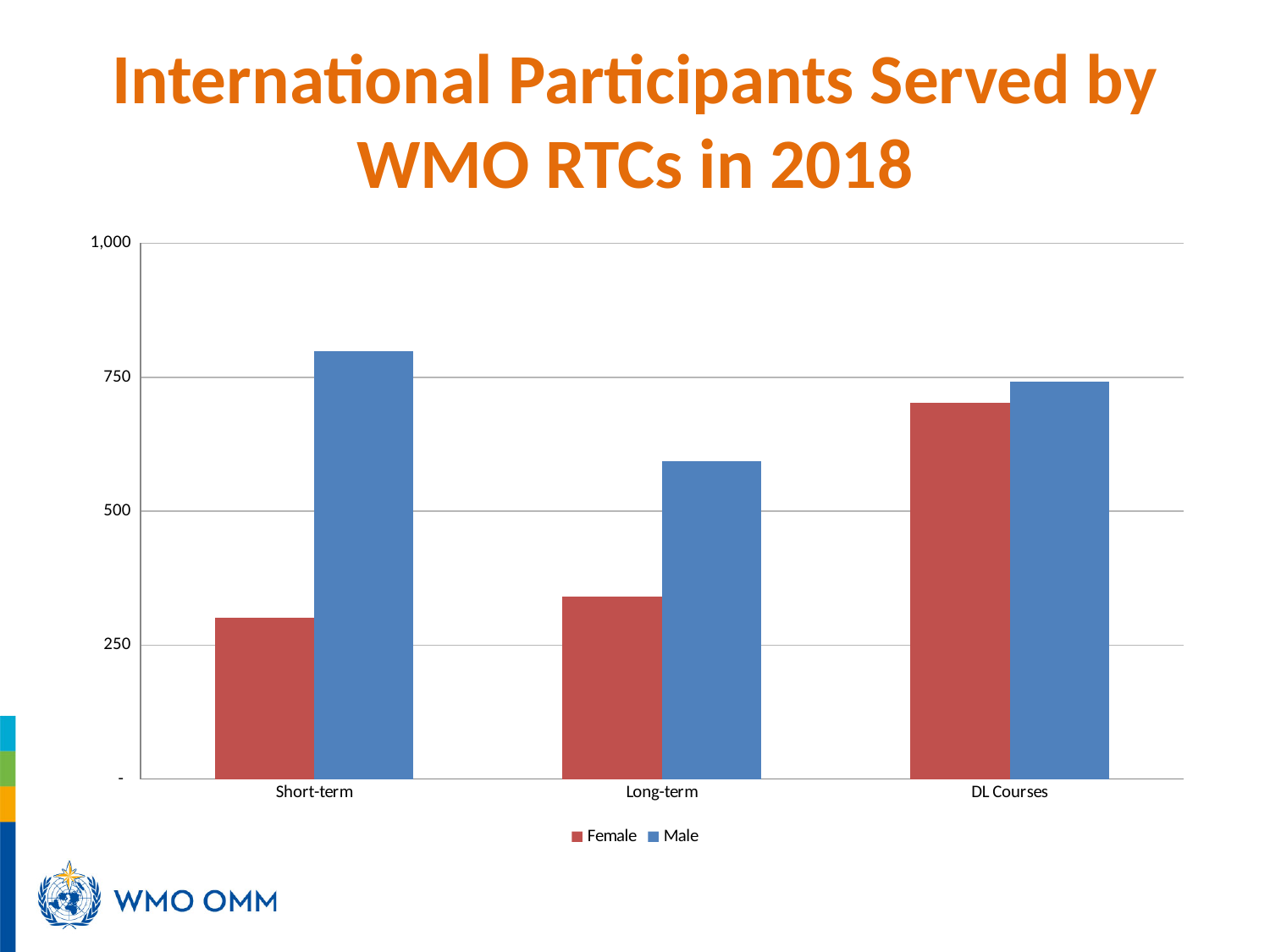
Which category has the highest Male value? Short-term Is the Male value for Long-term greater or less than 500? greater Which category has the lowest Male value? Long-term Which series is shown in blue? Male Which category has the highest Female value? DL Courses How many series does the legend list? 2 Is the Male value for Short-term greater or less than 750? greater For Short-term, which is larger, the Female value or the Male value? Male Is the Female value for Long-term greater or less than 500? less What is the title of the chart? International Participants Served by WMO RTCs in 2018 What kind of chart is shown on the slide? bar chart How many categories are shown on the x axis? 3